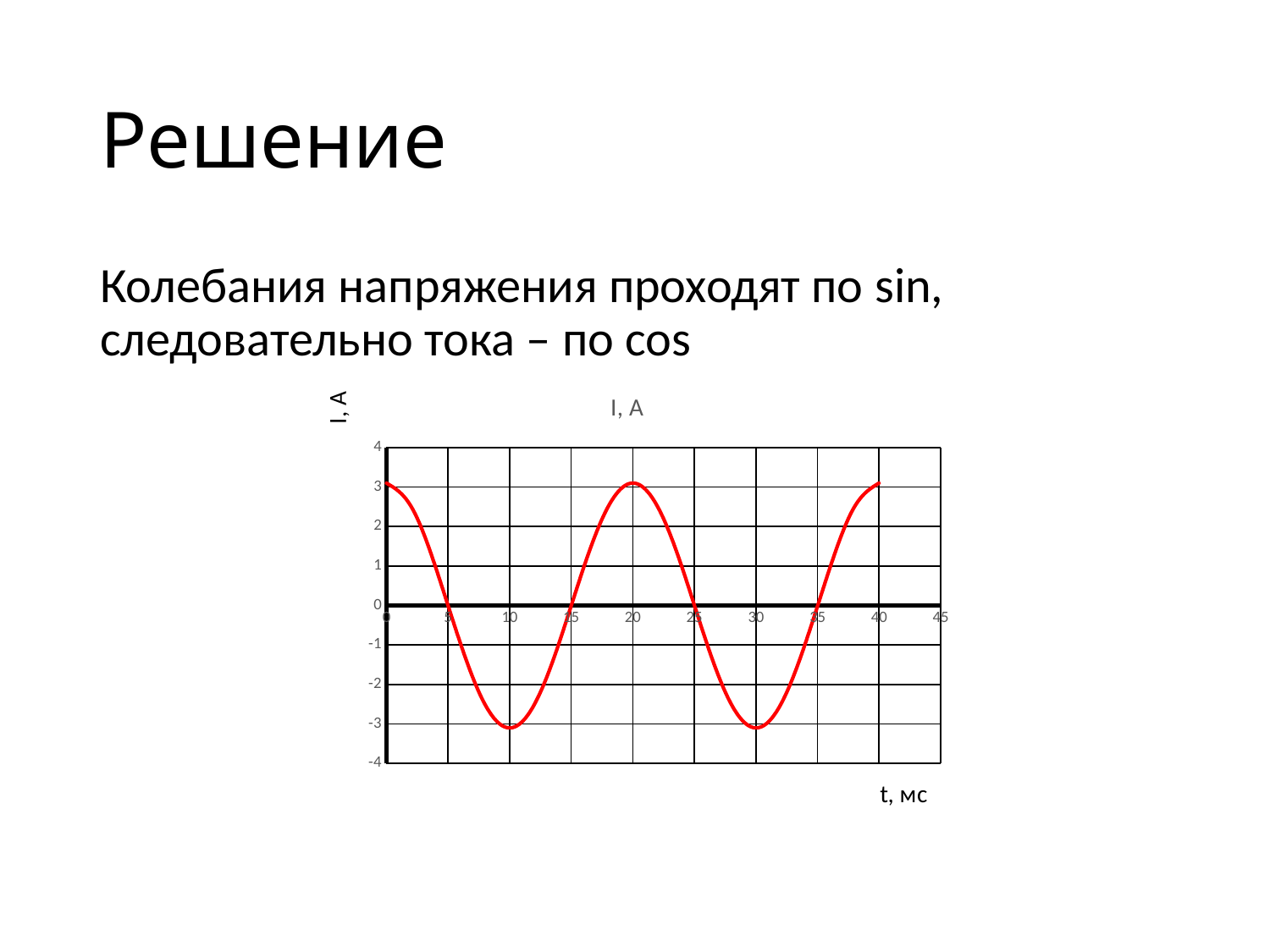
Does the value of I rise or fall as t goes from 10 to 20 on the chart? rise What is the title of the chart? I, A What is the label of the horizontal axis of the chart? t, мс What kind of chart is shown on the slide? line chart Does the value of I rise or fall as t goes from 0 to 10 on the chart? fall Is the value of I at t = 30 greater or less than 0? less